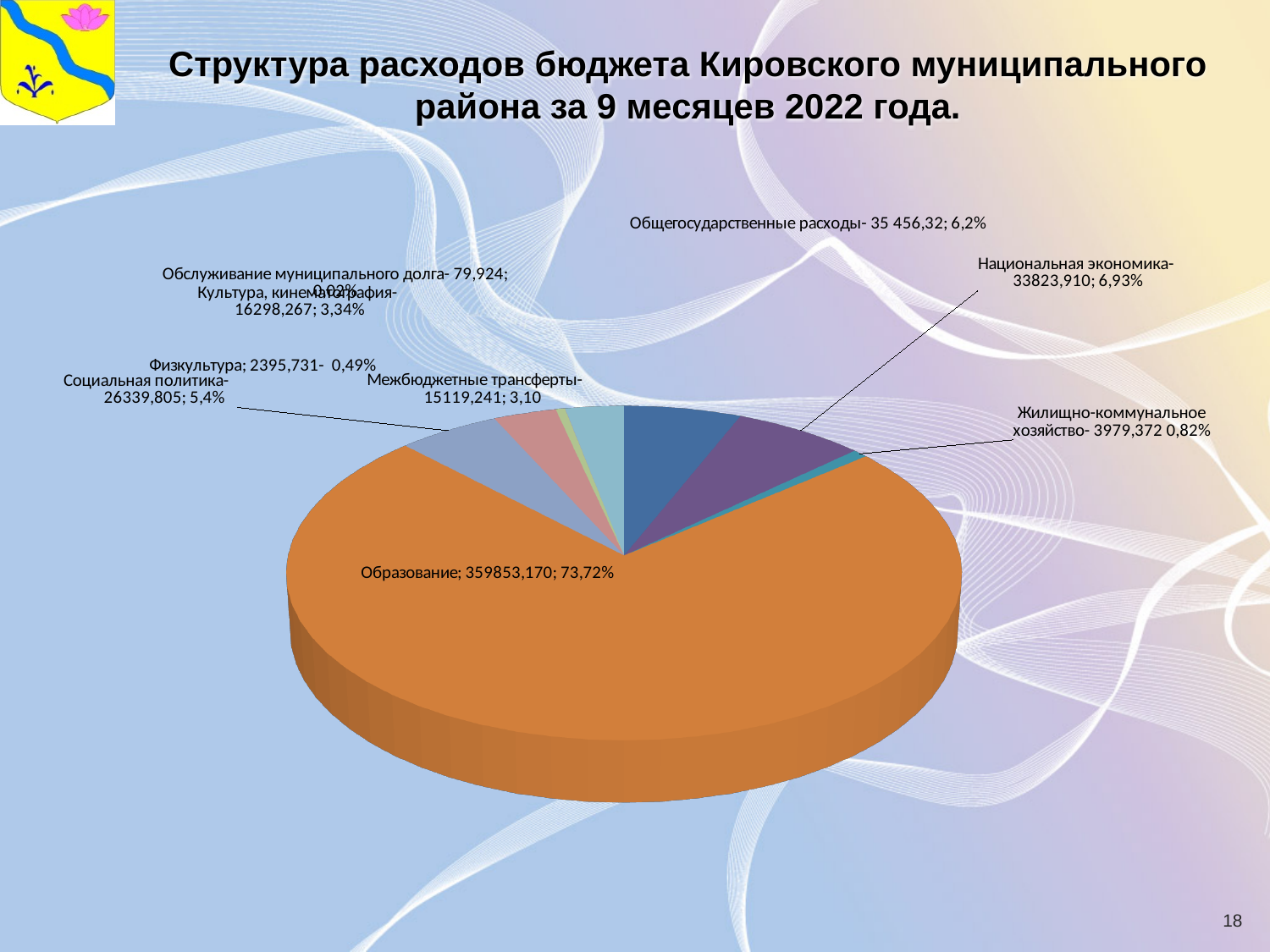
What value is shown for Национальная экономика? 33823,910 What value is shown for Образование? 359853,170 How many categories are shown in the pie chart? 9 Which category has the smallest value? Обслуживание муниципального долга What value is shown for Жилищно-коммунальное хозяйство? 3979,372 What kind of chart is shown on the slide? pie chart What percentage is shown for Культура, кинематография? 3,34% What is the title of the slide? Структура расходов бюджета Кировского муниципального района за 9 месяцев 2022 года. What percentage is shown for Социальная политика? 5,4% Which category has the largest share of the pie? Образование Which has a larger share: Национальная экономика or Общегосударственные расходы? Национальная экономика What share of the pie does Образование account for? 73,72%